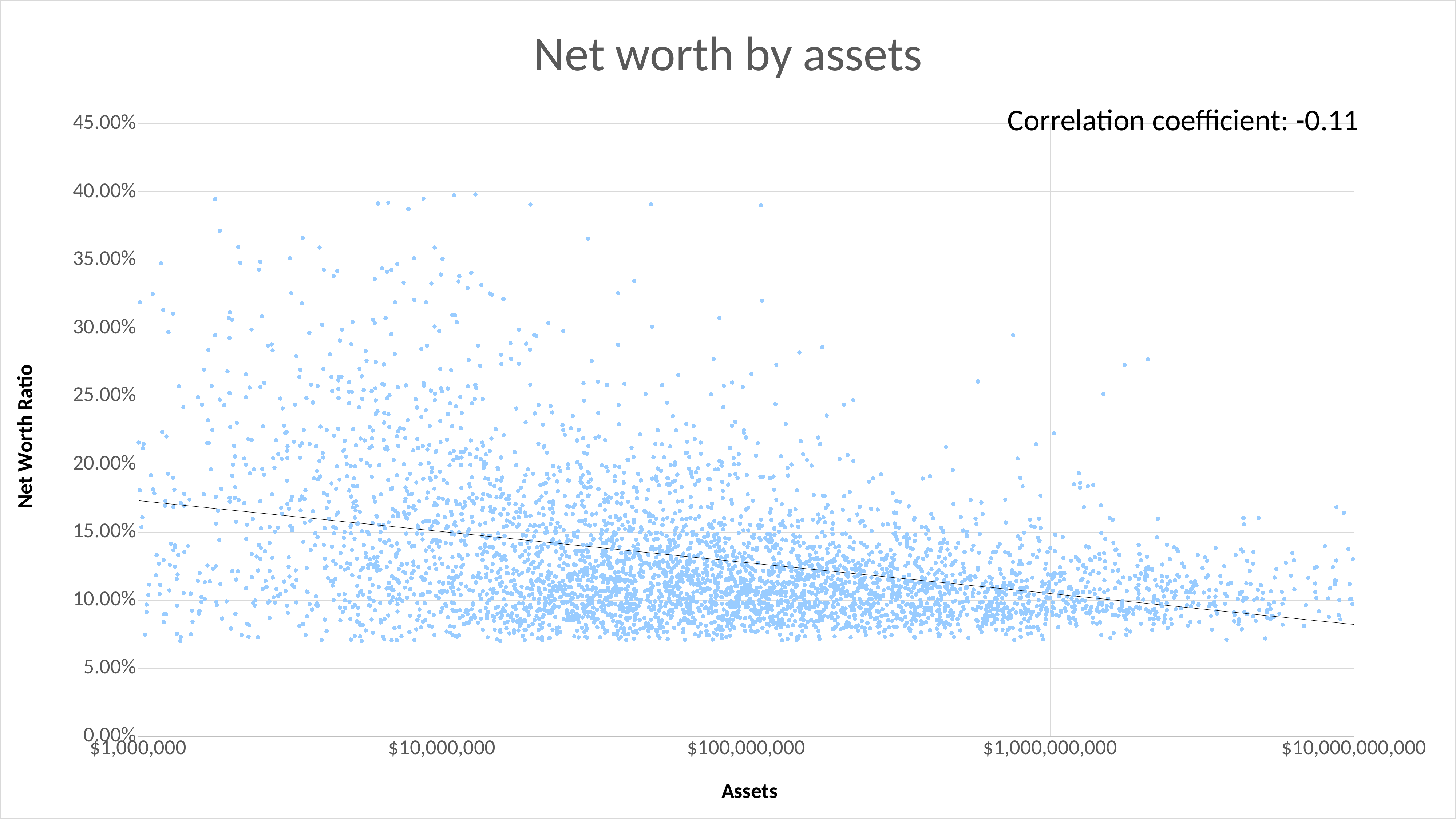
Does the trend line rise or fall as assets increase along the x axis? Fall Is the trend line's value at $1,000,000 in assets greater or less than 15.00%? greater Is the trend line's value at $10,000,000,000 in assets greater or less than 10.00%? less Are any points plotted below 5.00% net worth ratio? No What kind of chart is shown on the slide? Scatter chart What correlation coefficient is printed on the chart? -0.11 What is the title of the chart? Net worth by assets